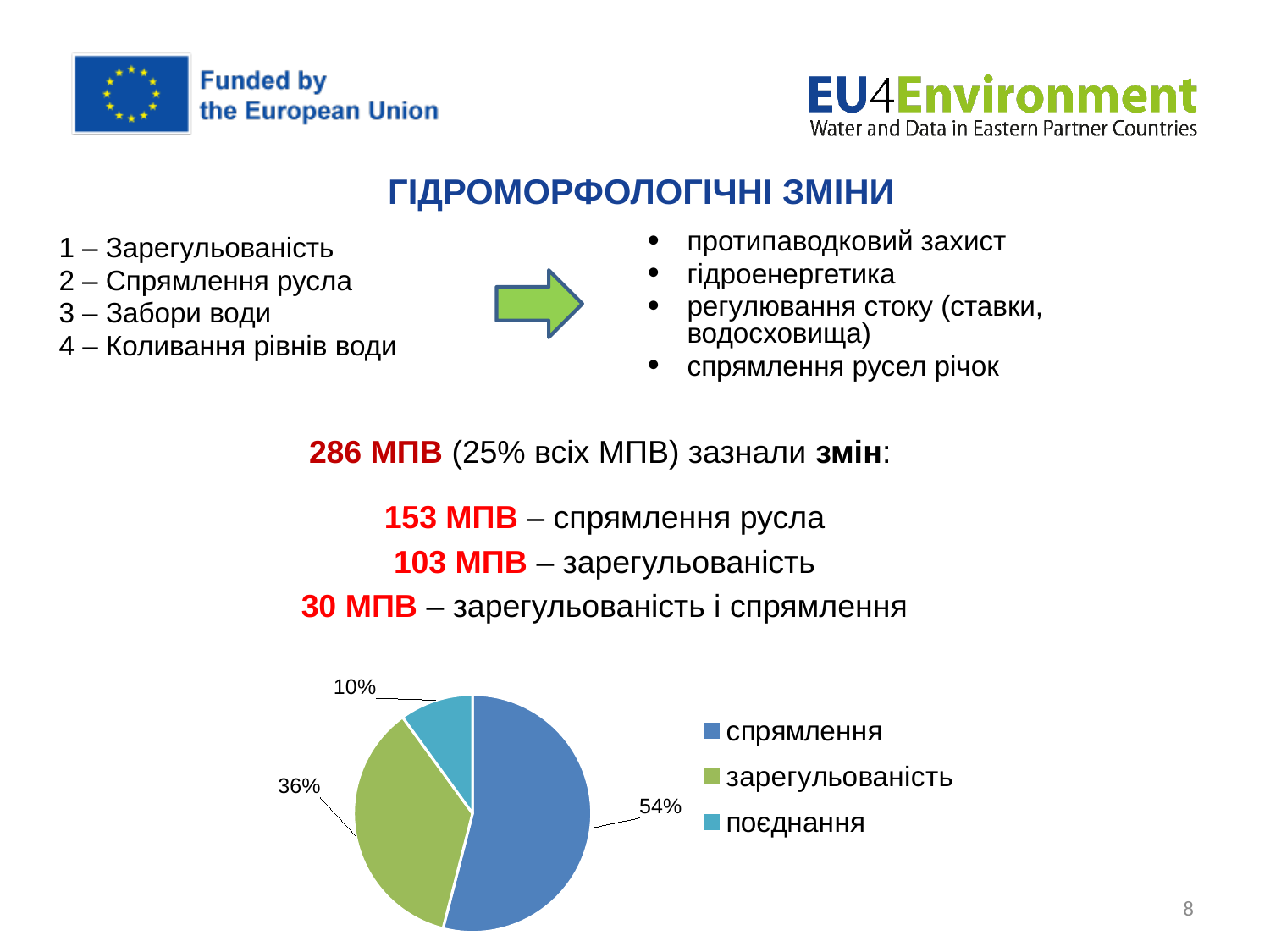
How many slices does the pie chart have? 3 Which slice of the pie chart is the smallest? поєднання Which slice of the pie chart is the largest? спрямлення What colour is the "поєднання" slice in the pie chart? light blue What share of the pie does the "зарегульованість" slice represent? 36% Which legend entry is shown in green in the pie chart? зарегульованість Which is larger in the pie chart: "зарегульованість" or "поєднання"? зарегульованість What kind of chart is shown on the slide? pie chart What share of the pie does the "спрямлення" slice represent? 54% How many entries does the legend of the pie chart list? 3 What share of the pie does the "поєднання" slice represent? 10% What is the difference in percentage points between the "спрямлення" and "зарегульованість" slices? 18